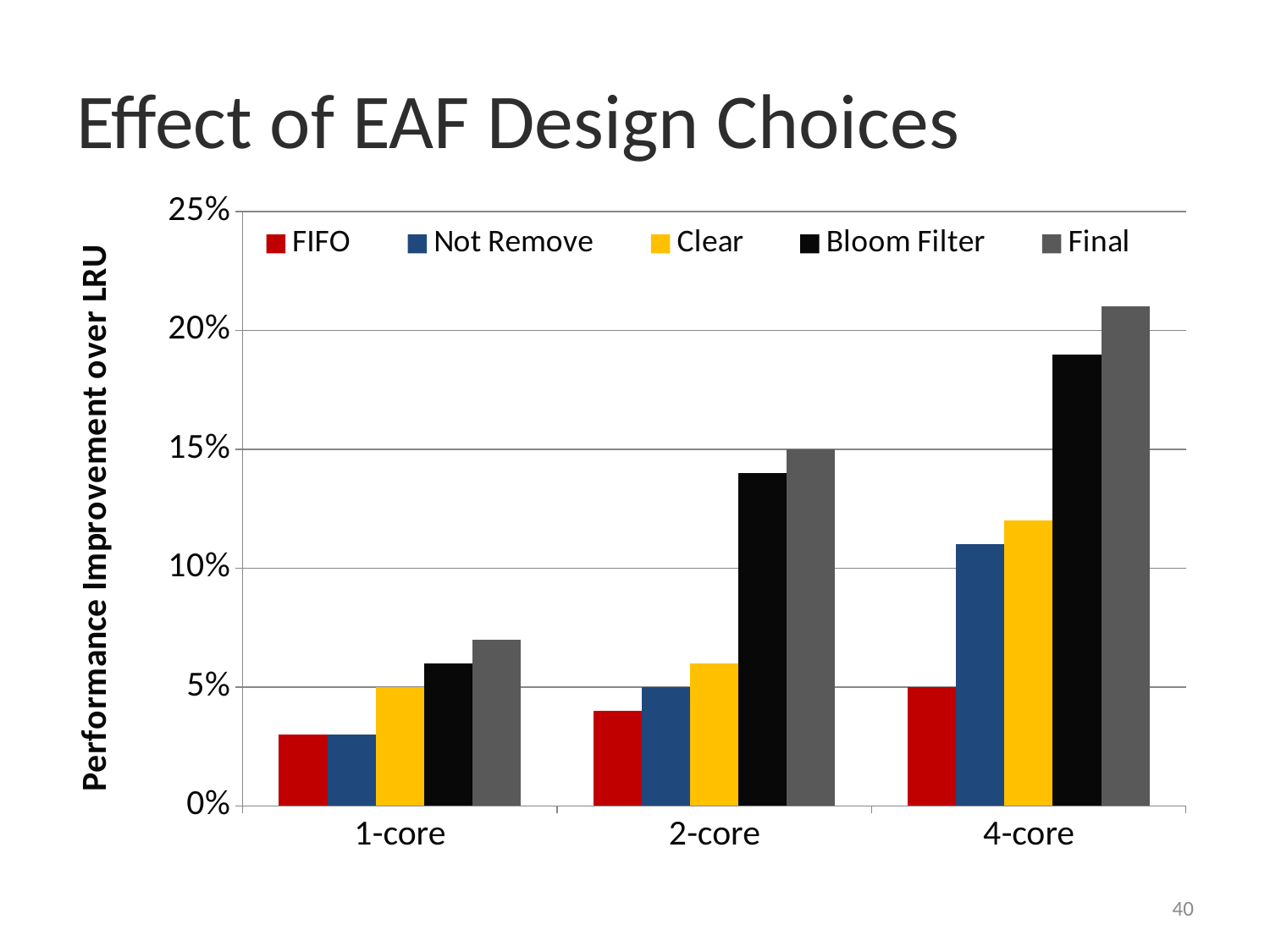
What kind of chart is shown on the slide? bar chart What is the value for FIFO in the 4-core category? 5% How many categories are shown on the x axis? 3 Which series has the highest value in the 4-core category? Final Is the value for Final in the 4-core category greater or less than 20%? greater What is the value for Final in the 2-core category? 15% Does the value for Final rise or fall from 1-core to 4-core? rise How many series does the legend list? 5 Which is larger: Bloom Filter in the 4-core category or Clear in the 4-core category? Bloom Filter Which series has the lowest value in the 2-core category? FIFO Is the value for Bloom Filter in the 2-core category greater or less than 10%? greater What is the value for Clear in the 1-core category? 5%